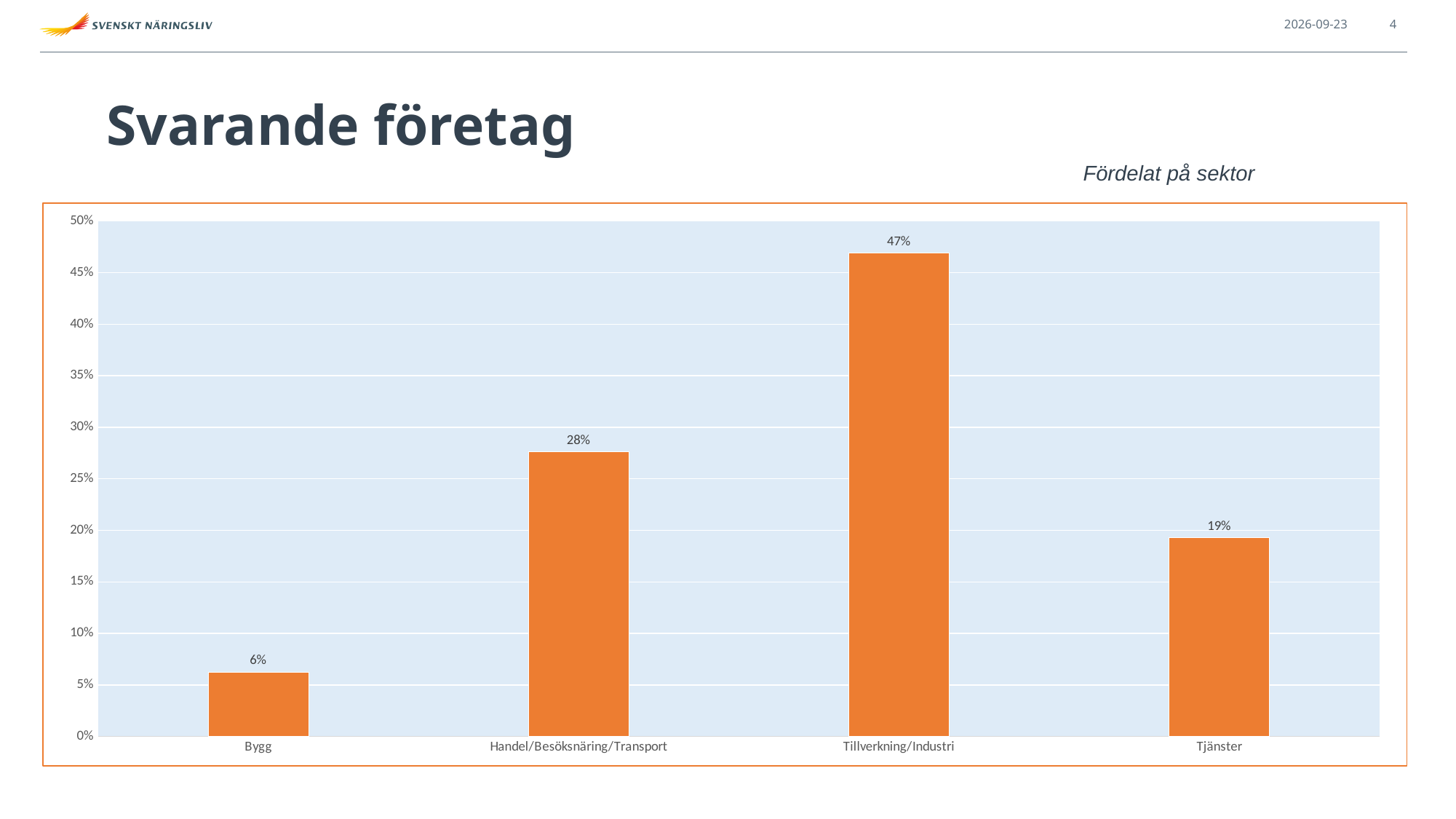
What is the value for Tjänster? 19% Which is larger, the value for Handel/Besöksnäring/Transport or the value for Tjänster? Handel/Besöksnäring/Transport What kind of chart is shown on the slide? Bar chart Is the value for Tillverkning/Industri greater or less than 45%? greater Which sector has the highest value? Tillverkning/Industri What is the difference between the values for Tillverkning/Industri and Handel/Besöksnäring/Transport? 19% What is the difference between the values for Tjänster and Bygg? 13% How many sectors are shown on the chart? 4 Which sector has the lowest value? Bygg What is the value for Tillverkning/Industri? 47% What is the value for Bygg? 6% What is the value for Handel/Besöksnäring/Transport? 28%